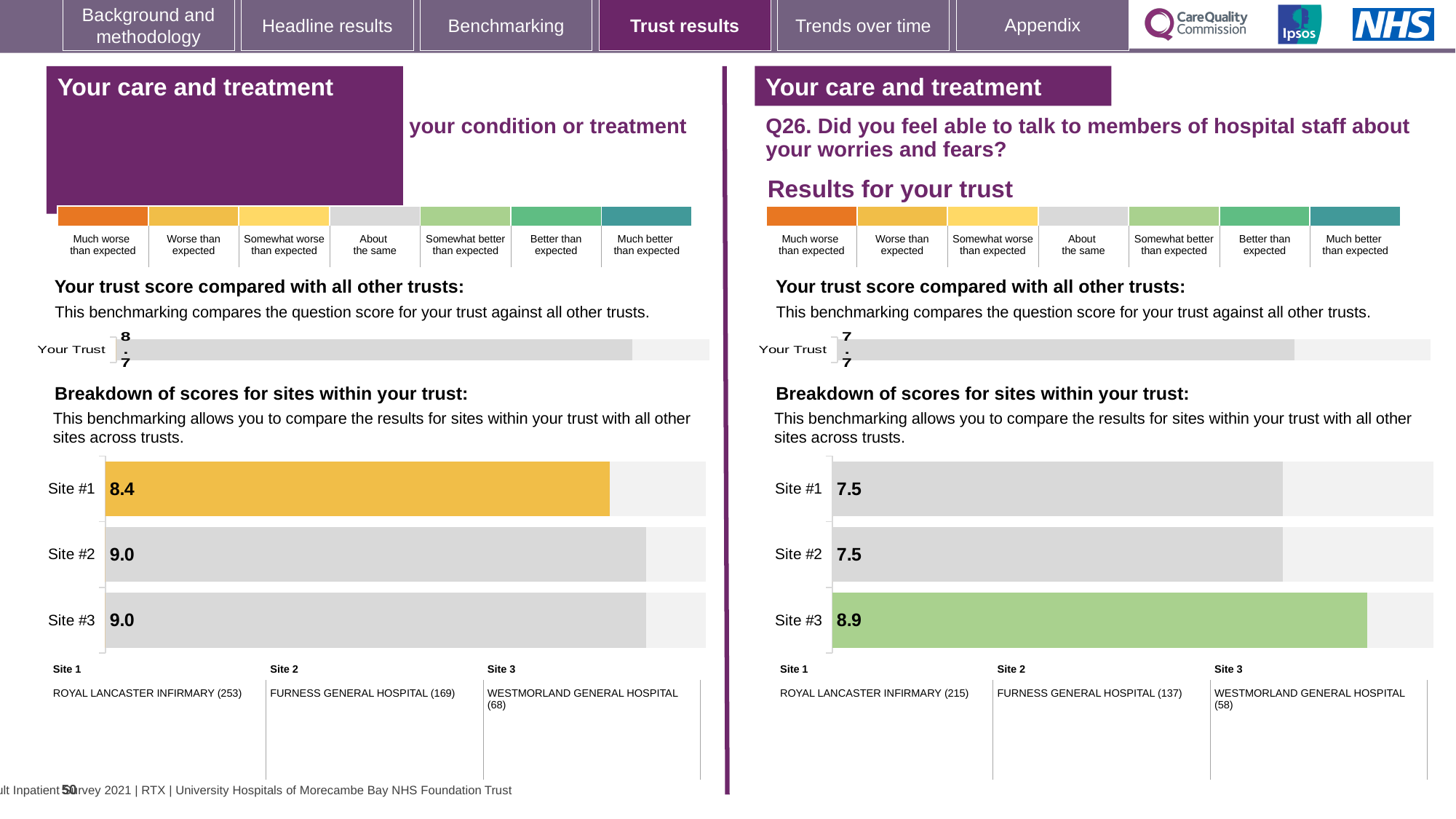
In the right-hand (Q26) 'Breakdown of scores for sites within your trust' chart, what is the difference between the scores for Site #3 and Site #2? 1.4 In the right-hand (Q26) 'Breakdown of scores for sites within your trust' chart, what is the score for Site #1? 7.5 In the right-hand (Q26) 'Breakdown of scores for sites within your trust' chart, what colour is the bar for Site #3? green In the left-hand 'Breakdown of scores for sites within your trust' chart, what is the score for Site #2? 9.0 In the left-hand 'Breakdown of scores for sites within your trust' chart, which site has the lowest score? Site #1 In the right-hand (Q26) 'Breakdown of scores for sites within your trust' chart, what is the score for Site #3? 8.9 In the right-hand (Q26) 'Breakdown of scores for sites within your trust' chart, which site has the highest score? Site #3 In the left-hand 'Breakdown of scores for sites within your trust' chart, how many sites are shown? 3 In the right-hand (Q26) 'Breakdown of scores for sites within your trust' chart, is the score for Site #3 larger or smaller than the score for Site #1? larger In the left-hand 'Breakdown of scores for sites within your trust' chart, what is the difference between the scores for Site #2 and Site #1? 0.6 In the left-hand 'Breakdown of scores for sites within your trust' chart, what is the score for Site #1? 8.4 What type of chart is used for the 'Breakdown of scores for sites within your trust' on the right-hand (Q26) side of the slide? bar chart